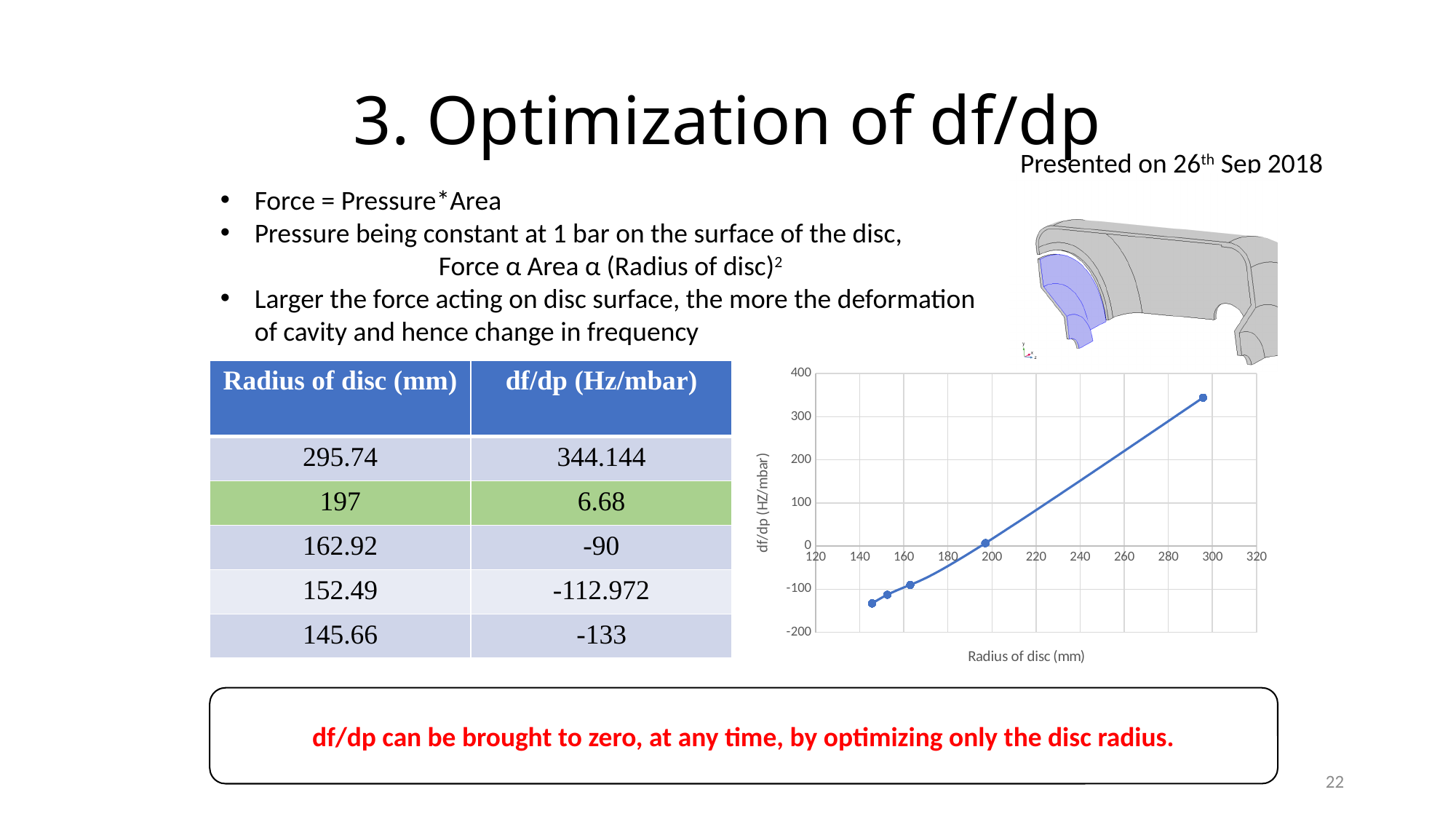
How many data points are plotted on the chart? 5 At which radius of disc is df/dp highest? 295.74 What is the label of the y axis of the chart? df/dp (HZ/mbar) At which radius of disc is df/dp lowest? 145.66 What kind of chart is shown on the slide? line chart What is the df/dp value for a disc radius of 295.74 mm? 344.144 What is the df/dp value for a disc radius of 197 mm? 6.68 Which has the larger df/dp value: a disc radius of 162.92 mm or 152.49 mm? 162.92 mm Is the df/dp value at a disc radius of 295.74 mm greater or less than 300? greater Does df/dp rise or fall as the radius of disc increases along the x axis? rise What is the label of the x axis of the chart? Radius of disc (mm) Is the df/dp value at a disc radius of 145.66 mm greater or less than -100? less